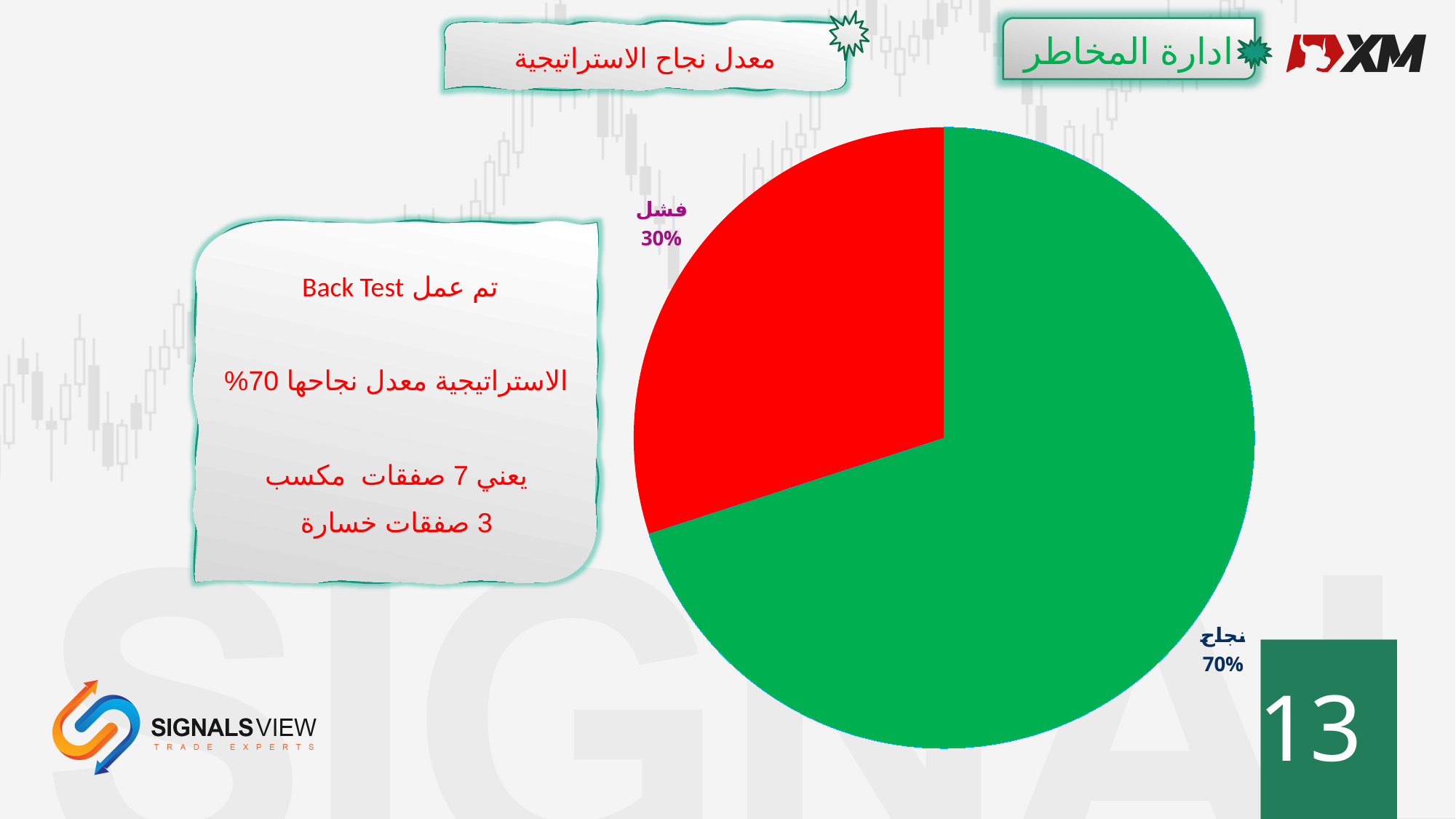
Which is larger, the نجاح slice or the فشل slice? نجاح Which slice of the pie is the smallest? فشل What share of the pie does the فشل slice represent? 30% What is the total of the two slices shown on the pie chart? 100% Which slice of the pie is the largest? نجاح What colour is the نجاح slice? green What kind of chart is shown on the slide? pie chart What share of the pie does the نجاح slice represent? 70% How many slices does the pie chart have? 2 What is the difference in percentage points between the نجاح slice and the فشل slice? 40% What colour is the فشل slice? red Is the value for فشل greater or less than 50%? less